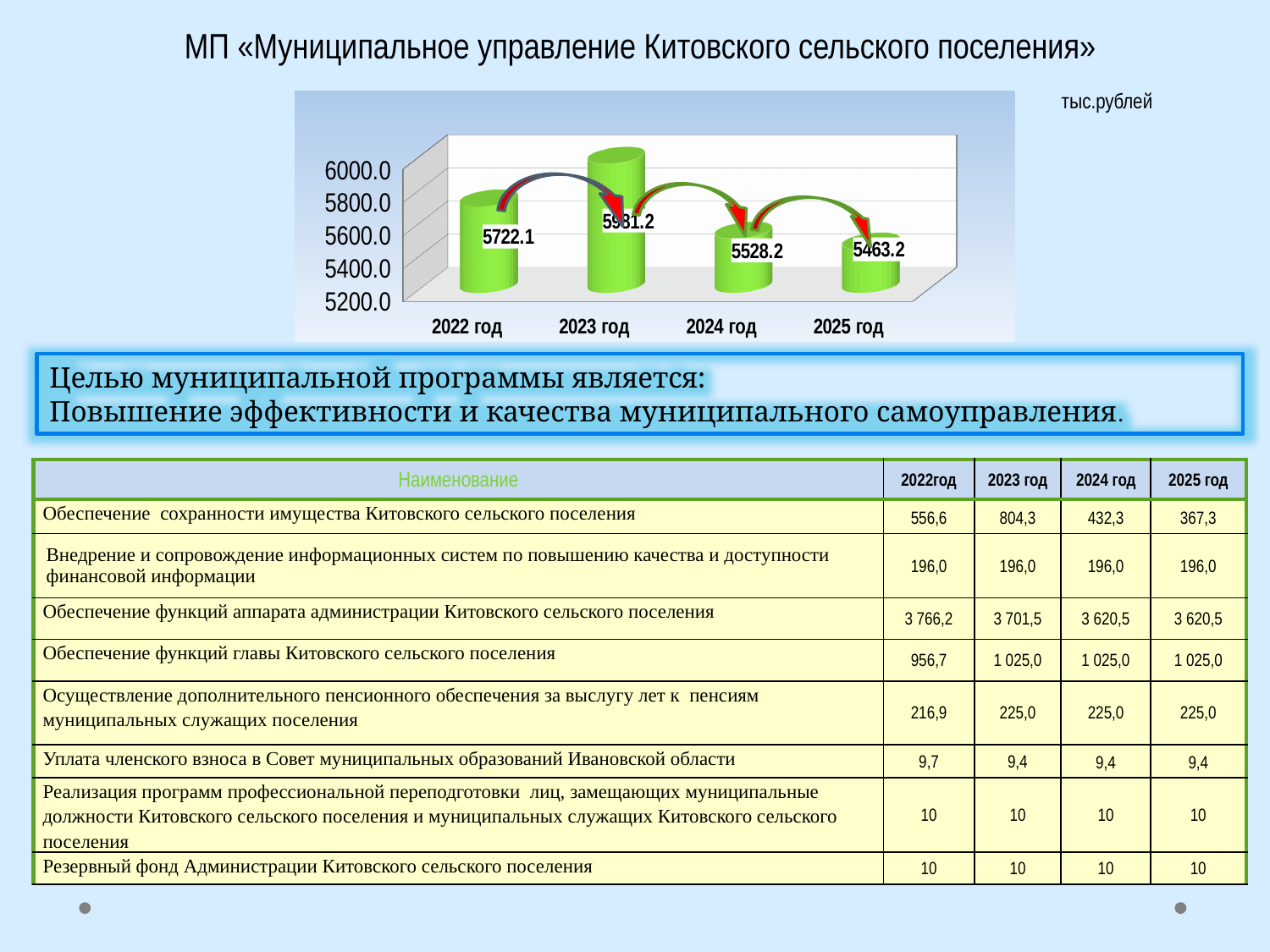
How many years are shown on the chart? 4 What is the difference between the values for 2024 год and 2025 год? 65.0 Is the value for 2023 год greater or less than 5800.0? greater What is the difference between the values for 2022 год and 2024 год? 193.9 Which is larger, the value for 2022 год or the value for 2025 год? 2022 год What is the value for 2022 год on the chart? 5722.1 Do the values rise or fall from 2023 год to 2025 год? fall Which year has the highest value on the chart? 2023 год Which year has the lowest value on the chart? 2025 год What is the value for 2025 год on the chart? 5463.2 What kind of chart is shown on the slide? bar chart What is the value for 2024 год on the chart? 5528.2